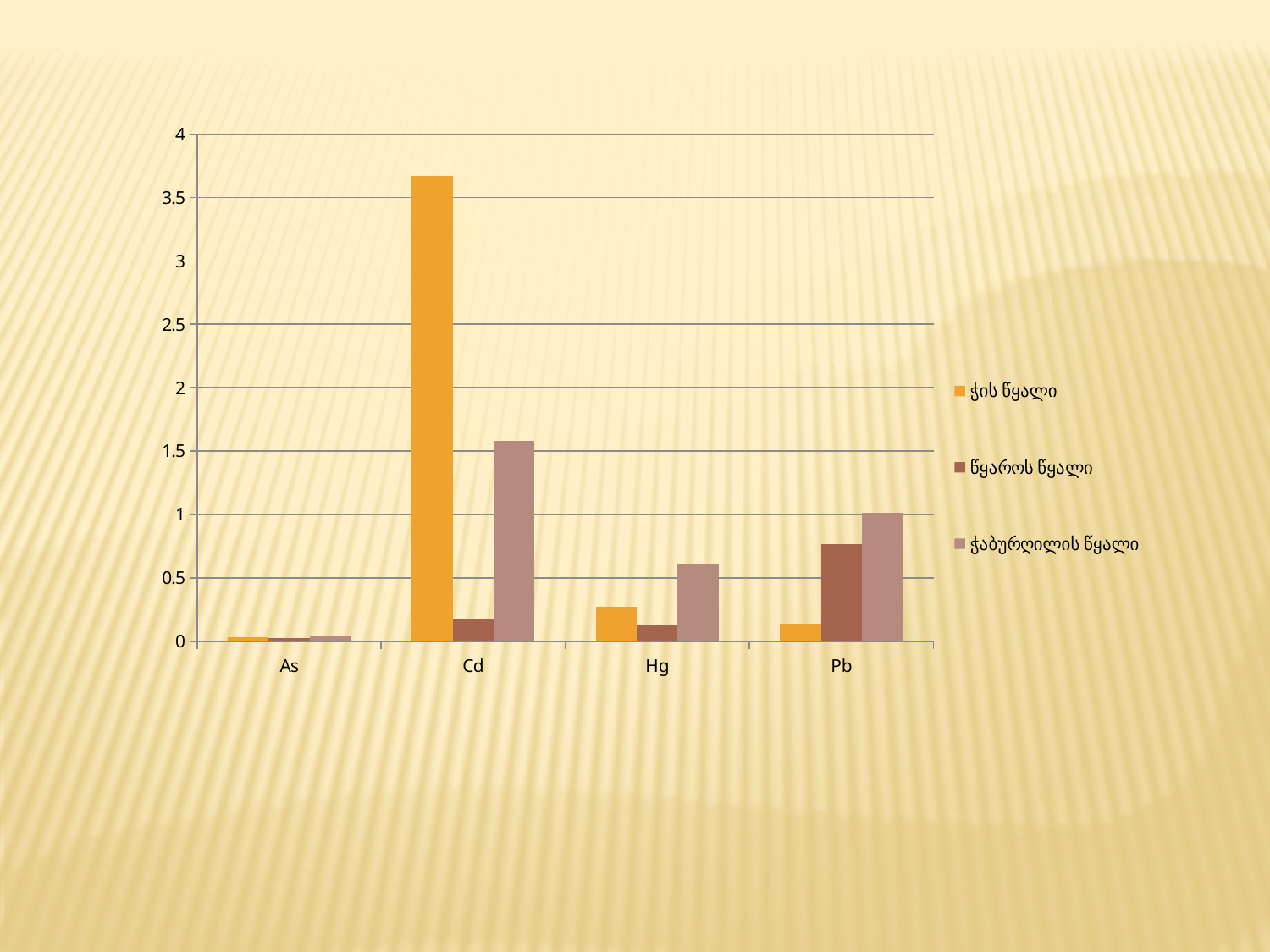
Is the value for წყაროს წყალი at Pb greater or less than 1? less How many categories are shown on the x axis? 4 At Pb, which series has the larger value: ჭის წყალი or წყაროს წყალი? წყაროს წყალი Is the value for ჭის წყალი at Cd greater or less than 3.5? greater Is the value for ჭაბურღილის წყალი at Hg greater or less than 0.5? greater How many series does the legend list? 3 Which category has the tallest bar in the chart? Cd At Cd, which series has the larger value: ჭის წყალი or ჭაბურღილის წყალი? ჭის წყალი Which category has the lowest value for the ჭის წყალი series? As What kind of chart is shown on the slide? bar chart Which series is shown in orange in the legend? ჭის წყალი